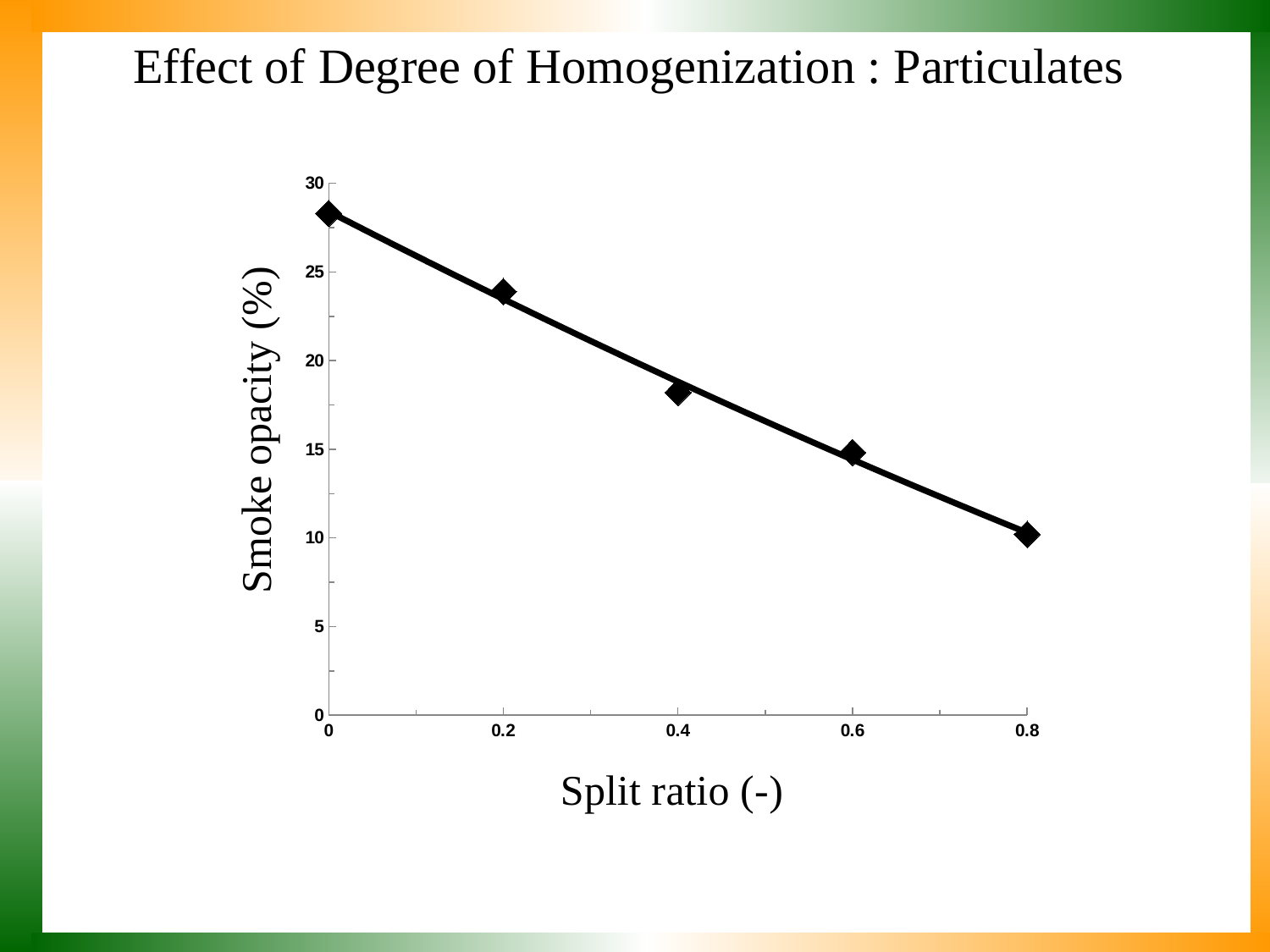
At which split ratio is smoke opacity highest? 0 Is the smoke opacity at split ratio 0.4 greater or less than 20? less How many data points are plotted on the chart? 5 What is the title of the chart on the slide? Effect of Degree of Homogenization : Particulates Is the smoke opacity at split ratio 0.2 greater or less than 25? less What kind of chart is shown on the slide? line chart Which has the higher smoke opacity, split ratio 0.2 or split ratio 0.6? 0.2 At which split ratio is smoke opacity lowest? 0.8 Does smoke opacity rise or fall as the split ratio increases? fall What is the label of the y axis? Smoke opacity (%) Is the smoke opacity at split ratio 0.8 greater or less than 15? less